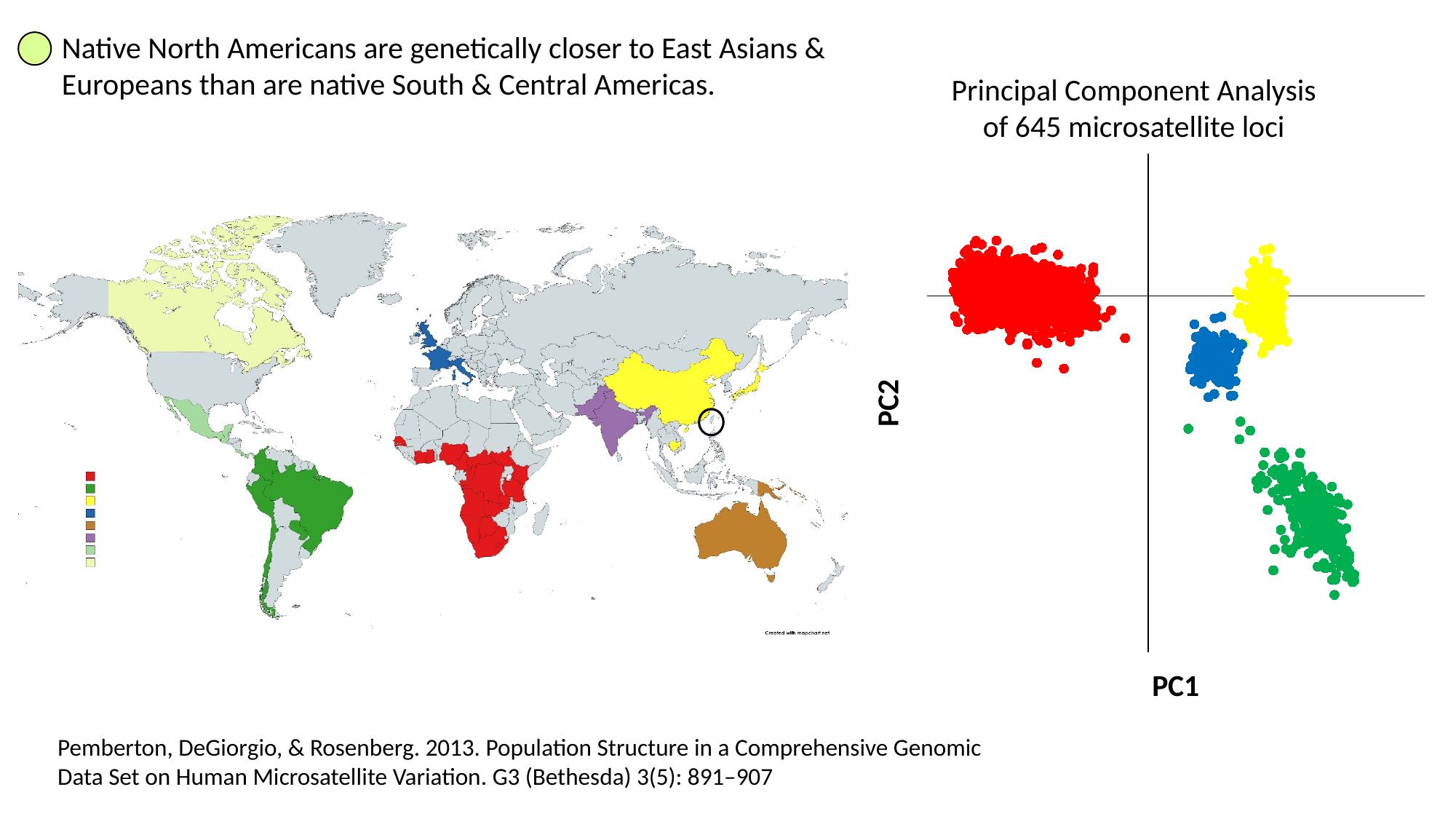
What is the title of the chart on the right side of the slide? Principal Component Analysis of 645 microsatellite loci In the Principal Component Analysis chart, what are the labels of the horizontal and vertical axes? PC1 and PC2 In the Principal Component Analysis chart, which cluster has the larger PC1 value, the red cluster or the blue cluster? blue In the Principal Component Analysis chart, which coloured cluster lies furthest to the left along PC1? red In the Principal Component Analysis chart, which coloured cluster lies lowest along PC2? green In the Principal Component Analysis chart, which cluster has the larger PC2 value, the yellow cluster or the green cluster? yellow What kind of chart is the 'Principal Component Analysis of 645 microsatellite loci' chart? scatter plot How many distinct coloured clusters of points are shown in the Principal Component Analysis chart? 4 In the Principal Component Analysis chart, which cluster is closest to the yellow cluster? blue In the Principal Component Analysis chart, which coloured cluster extends furthest to the right along PC1? green